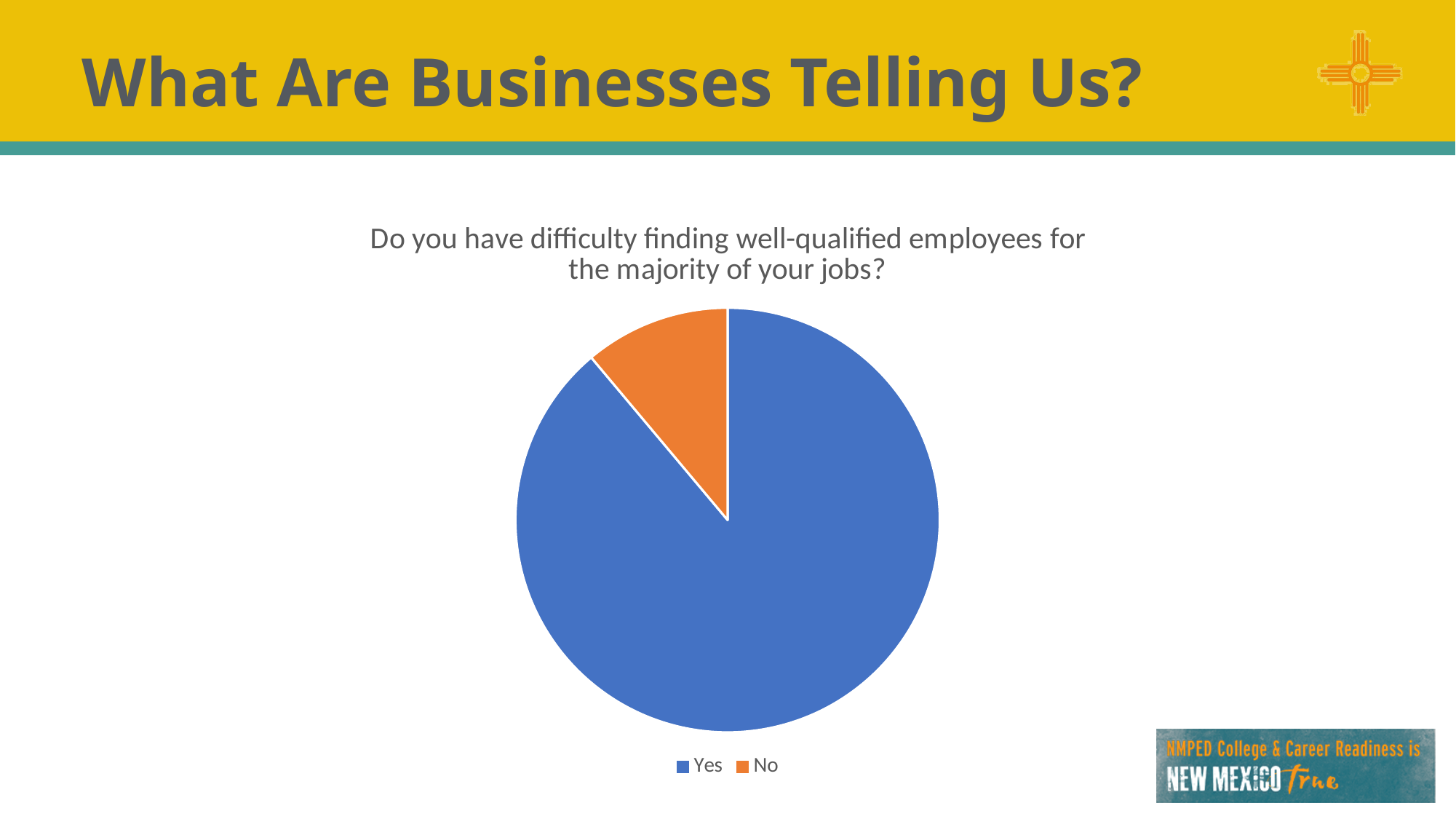
How many entries does the legend of the pie chart list? 2 What colour is the No slice in the pie chart? Orange Which response has the largest slice of the pie chart? Yes Which slice is larger, Yes or No? Yes Which response has the smallest slice of the pie chart? No How many slices does the pie chart have? 2 What kind of chart is shown on the slide? Pie chart What is the title of the pie chart? Do you have difficulty finding well-qualified employees for the majority of your jobs?